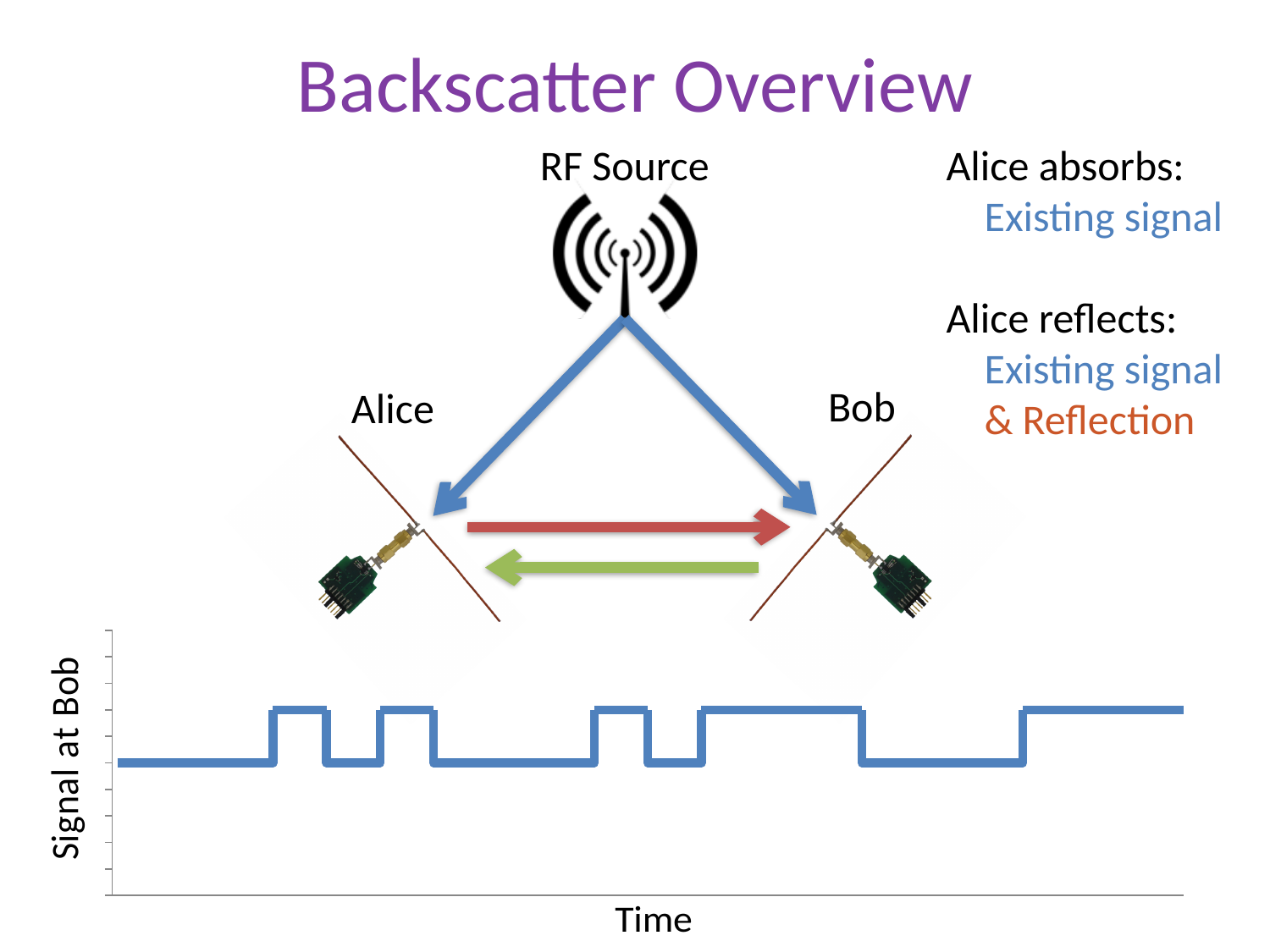
What is the label on the horizontal axis of the chart? Time At the right end of the time axis, is the signal at its high level or its low level? high At the left end of the time axis, is the signal at its high level or its low level? low What is the label on the vertical axis of the chart? Signal at Bob What kind of chart is shown at the bottom of the slide? line chart